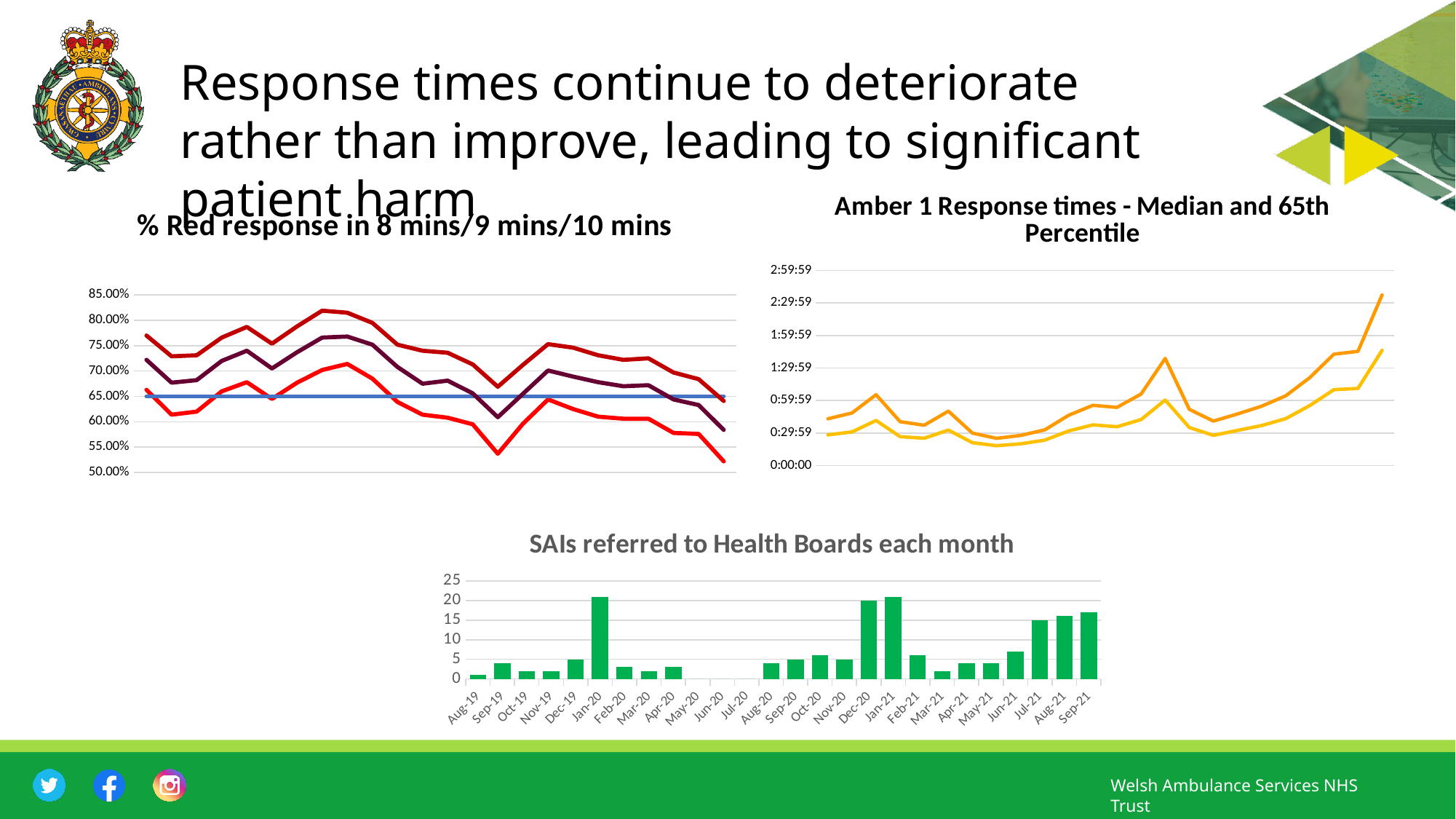
What kind of chart is 'SAIs referred to Health Boards each month'? bar chart In 'SAIs referred to Health Boards each month', is the value for Aug-19 greater or less than 5? less In 'SAIs referred to Health Boards each month', is the value for Jan-20 greater or less than 15? greater In 'SAIs referred to Health Boards each month', is the value for Feb-21 greater or less than 10? less In 'SAIs referred to Health Boards each month', do the bars rise or fall from Jul-21 to Sep-21? rise What is the highest value shown on the y axis of 'Amber 1 Response times - Median and 65th Percentile'? 2:59:59 How many months are shown on the x axis of 'SAIs referred to Health Boards each month'? 26 In 'Amber 1 Response times - Median and 65th Percentile', do the lines rise or fall over the final months on the right of the chart? rise What kind of chart is '% Red response in 8 mins/9 mins/10 mins'? line chart In 'SAIs referred to Health Boards each month', which is larger, the value for Jan-20 or the value for Feb-20? Jan-20 In 'SAIs referred to Health Boards each month', which is larger, the value for Sep-21 or the value for Mar-21? Sep-21